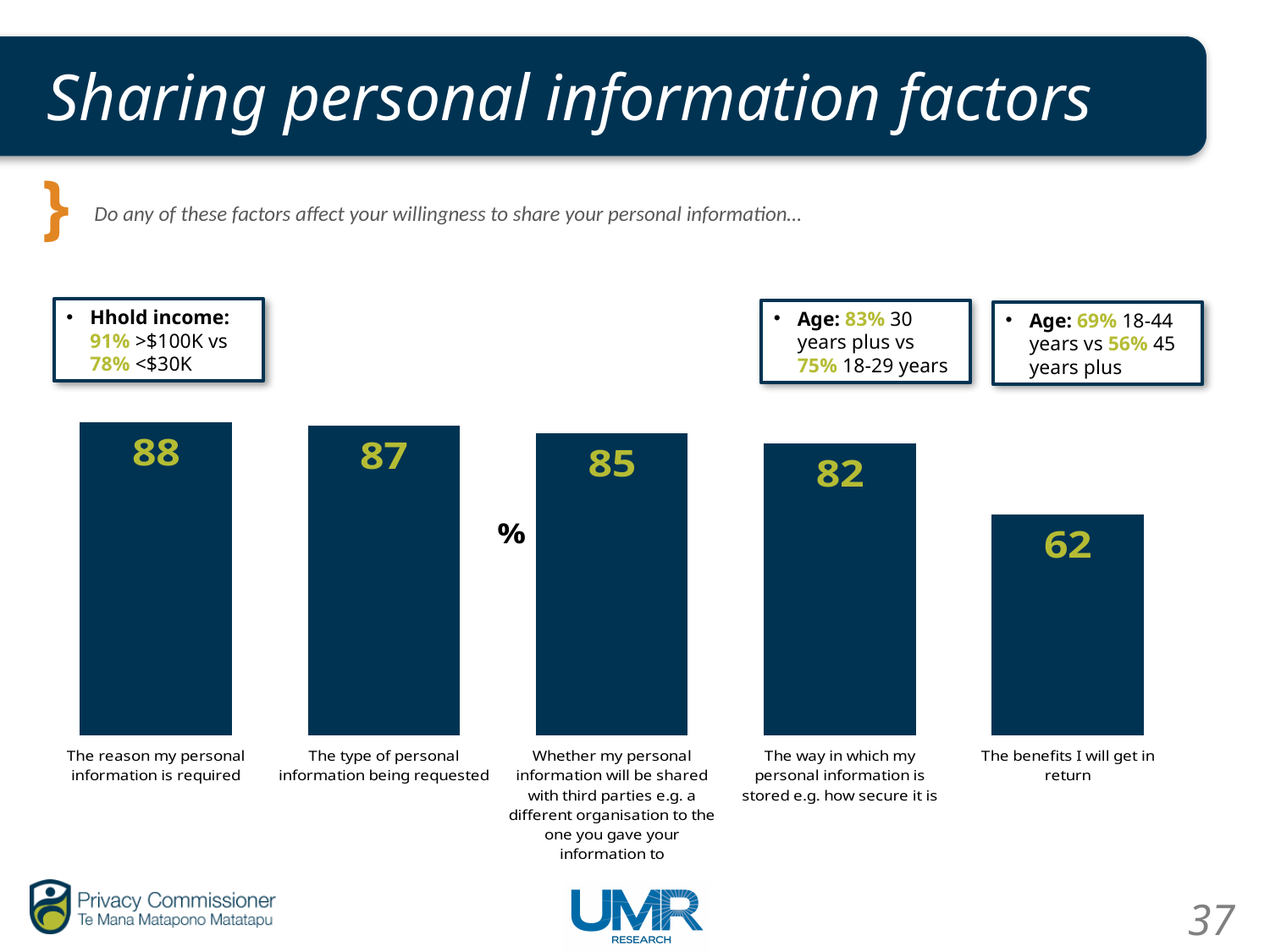
Which category has the lowest value? The benefits I will get in return Which is larger: the value for 'The way in which my personal information is stored' or the value for 'Whether my personal information will be shared with third parties'? Whether my personal information will be shared with third parties How many categories are shown in the chart? 5 What is the difference between the values for 'The reason my personal information is required' and 'The way in which my personal information is stored'? 6 What is the value for 'The benefits I will get in return'? 62 What kind of chart is shown on the slide? Bar chart What is the value for 'The way in which my personal information is stored e.g. how secure it is'? 82 Do the values rise or fall from left to right across the chart? Fall What is the difference between the values for 'The type of personal information being requested' and 'The benefits I will get in return'? 25 Which category has the highest value? The reason my personal information is required What unit label is shown next to the bars in the chart? % What is the value for 'The reason my personal information is required'? 88